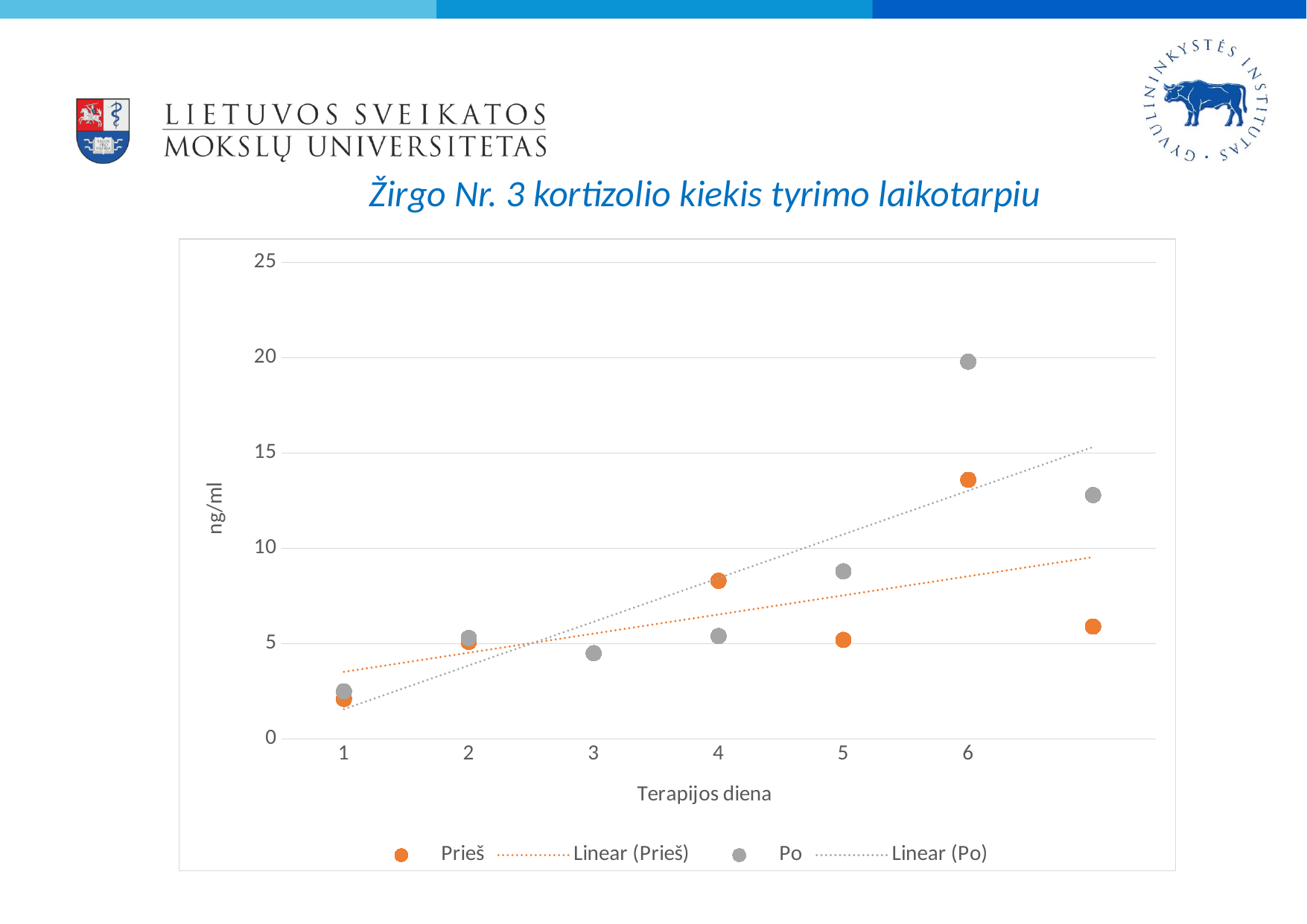
On which therapy day is the Po value lowest? 1 On which therapy day (Terapijos diena) is the Po value highest? 6 Is the Prieš value on day 6 greater or less than 10 ng/ml? greater On which therapy day is the Prieš value highest? 6 How many entries does the chart legend list? 4 Is the Po value on day 3 greater or less than 5 ng/ml? less What is the title of the chart's vertical axis? ng/ml Does the Linear (Po) trendline rise or fall as the therapy day increases? Rises What kind of chart is shown on the slide? Scatter chart On day 5, which is larger: the Prieš value or the Po value? Po Is the Po value on day 6 greater or less than 15 ng/ml? greater